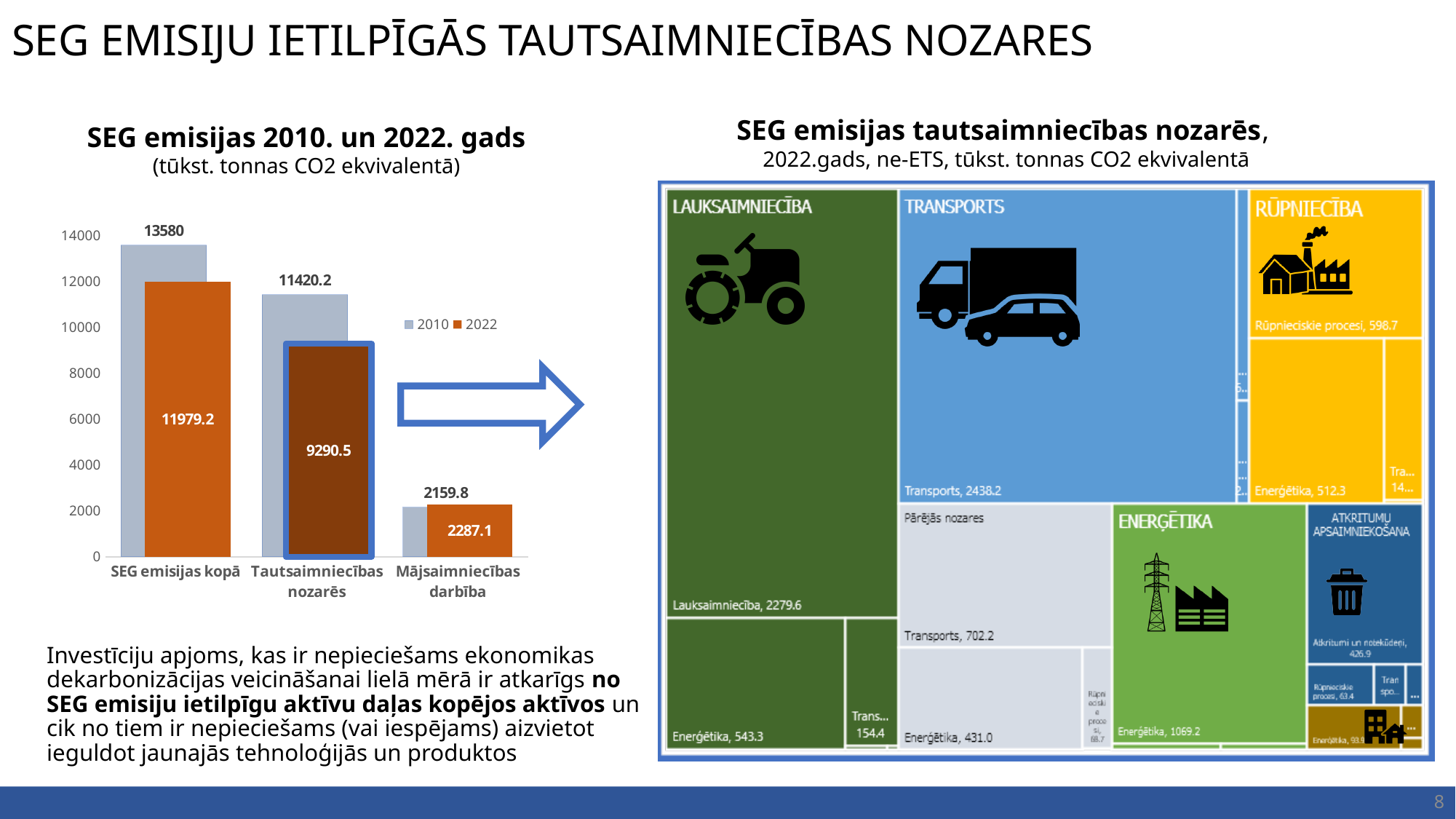
In the chart 'SEG emisijas tautsaimniecības nozarēs', what is the value for 'Transports' in the TRANSPORTS section? 2438.2 In the chart 'SEG emisijas tautsaimniecības nozarēs', what is the value for 'Lauksaimniecība' in the LAUKSAIMNIECĪBA section? 2279.6 In the chart 'SEG emisijas 2010. un 2022. gads', is the 2010 value for 'Mājsaimniecības darbība' larger or smaller than its 2022 value? smaller In the chart 'SEG emisijas 2010. un 2022. gads', which category has the lowest 2010 value? Mājsaimniecības darbība In the chart 'SEG emisijas 2010. un 2022. gads', what is the 2022 value for 'Mājsaimniecības darbība'? 2287.1 In the chart 'SEG emisijas 2010. un 2022. gads', what is the difference between the 2010 and 2022 values for 'SEG emisijas kopā'? 1600.8 In the chart 'SEG emisijas 2010. un 2022. gads', what is the 2010 value for 'SEG emisijas kopā'? 13580 In the chart 'SEG emisijas 2010. un 2022. gads', how many series does the legend list? 2 What kind of chart is 'SEG emisijas 2010. un 2022. gads'? bar chart In the chart 'SEG emisijas 2010. un 2022. gads', how many categories are shown on the x axis? 3 In the chart 'SEG emisijas tautsaimniecības nozarēs', what is the value for 'Rūpnieciskie procesi' in the RŪPNIECĪBA section? 598.7 In the chart 'SEG emisijas 2010. un 2022. gads', what is the 2022 value for 'Tautsaimniecības nozarēs'? 9290.5